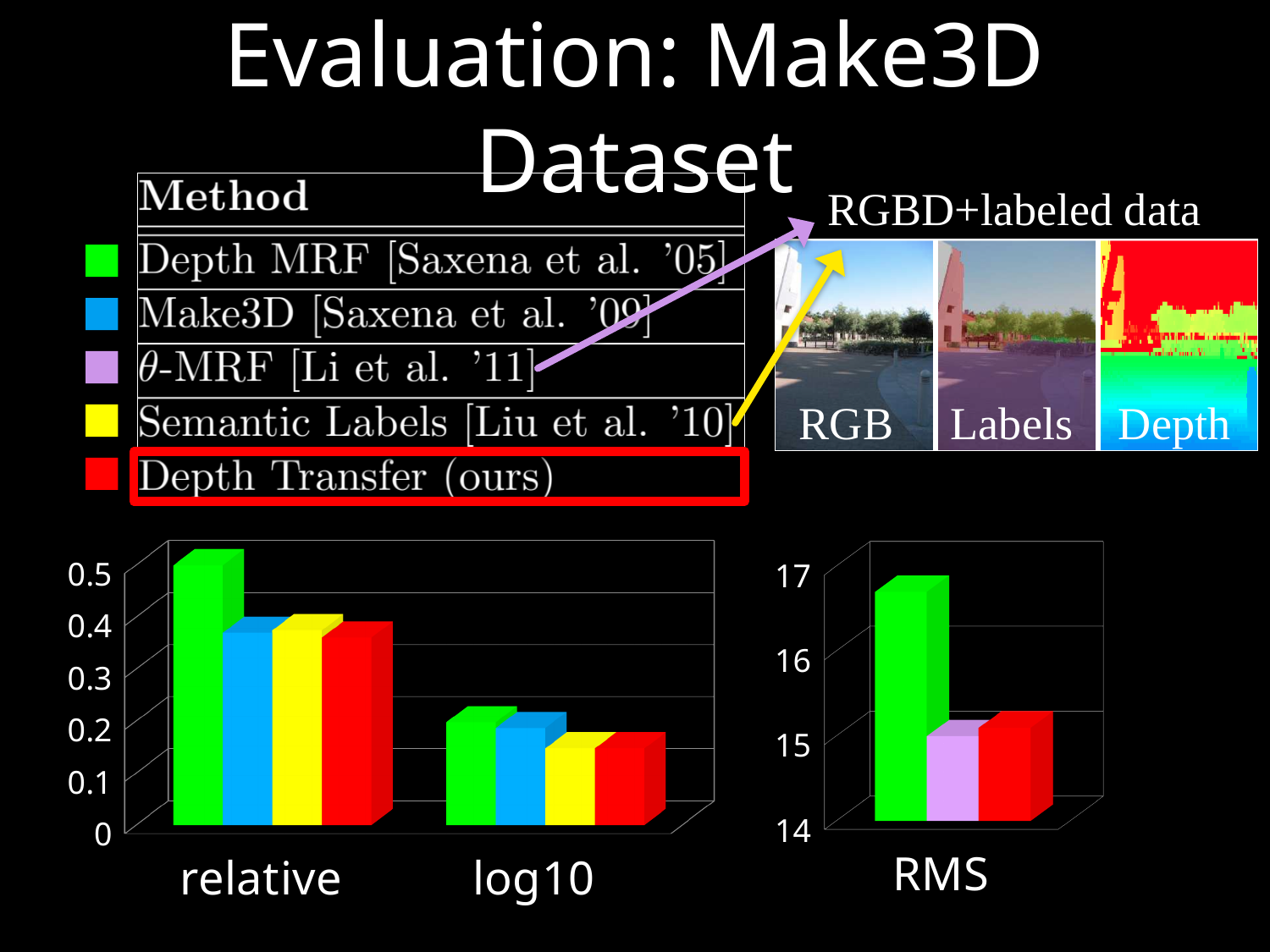
What kind of chart is the left chart with the categories 'relative' and 'log10'? bar chart In the left chart, which method has the highest bar for the 'relative' category? Depth MRF [Saxena et al. '05] In the left chart, is the 'relative' value for Depth MRF (green bar) greater or less than 0.5? greater How many categories are shown on the x axis of the left chart? 2 In the left chart, is the 'relative' value for Depth Transfer (red bar) greater or less than 0.5? less Which method is highlighted with a red box in the legend table? Depth Transfer (ours) In the right chart (RMS), is the value for Depth Transfer (red bar) greater or less than 16? less In the right chart (RMS), which method has the highest bar? Depth MRF [Saxena et al. '05] In the left chart, which is larger for the 'relative' category: the Depth MRF (green) bar or the Depth Transfer (red) bar? Depth MRF (green) What kind of chart is the right chart labeled 'RMS'? bar chart